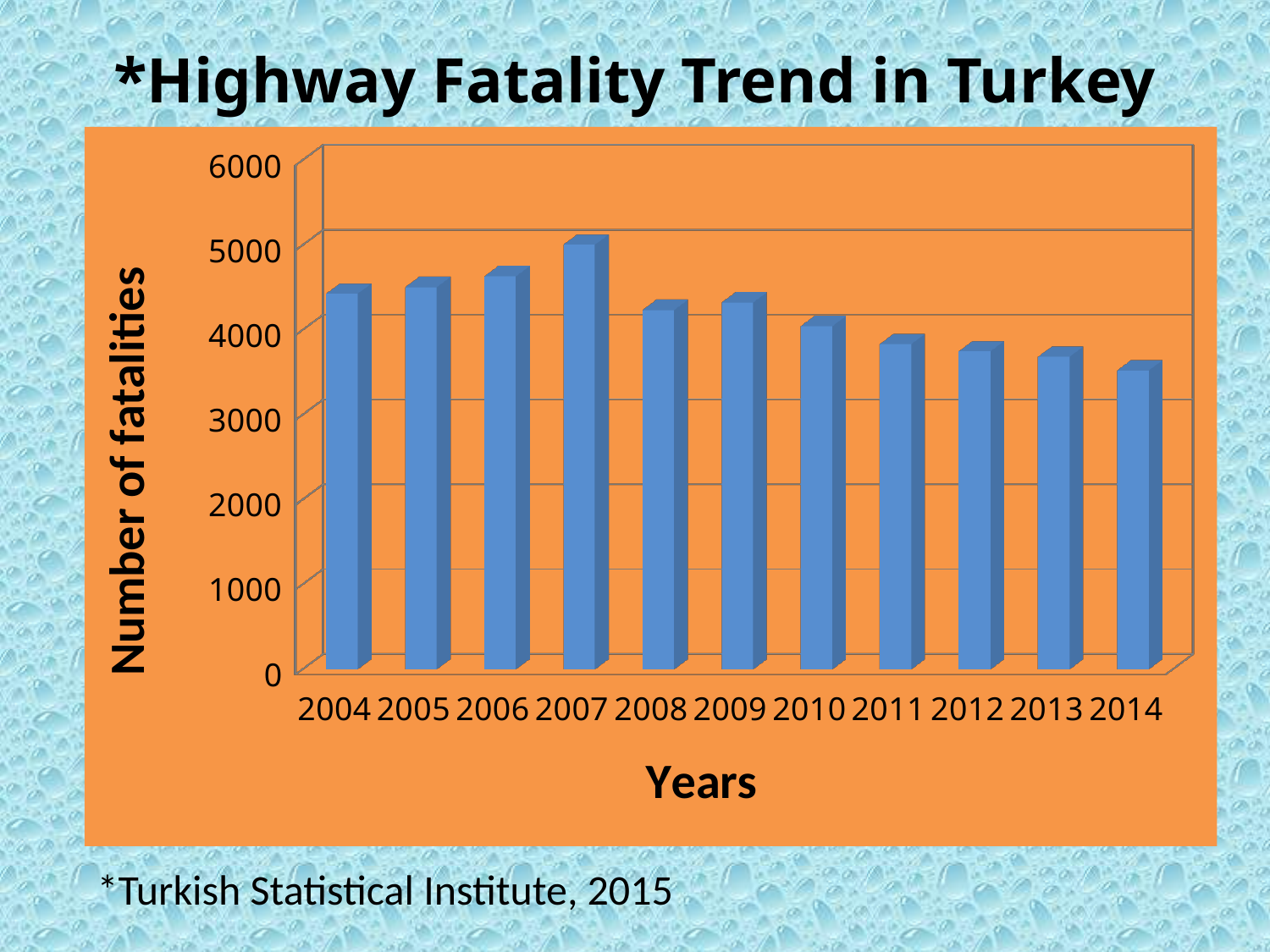
What kind of chart is shown on the slide? bar chart Is the value for 2007 greater or less than 4000? greater Which year has the lowest number of fatalities? 2014 Which year has more fatalities, 2006 or 2011? 2006 Is the value for 2014 greater or less than 4000? less Is the value for 2004 greater or less than 4000? greater What is the label of the vertical axis of the chart? Number of fatalities How many years are plotted on the x axis of the chart? 11 Which year has more fatalities, 2007 or 2014? 2007 From 2007 to 2014, do the number of fatalities generally rise or fall? fall Which year has the highest number of fatalities? 2007